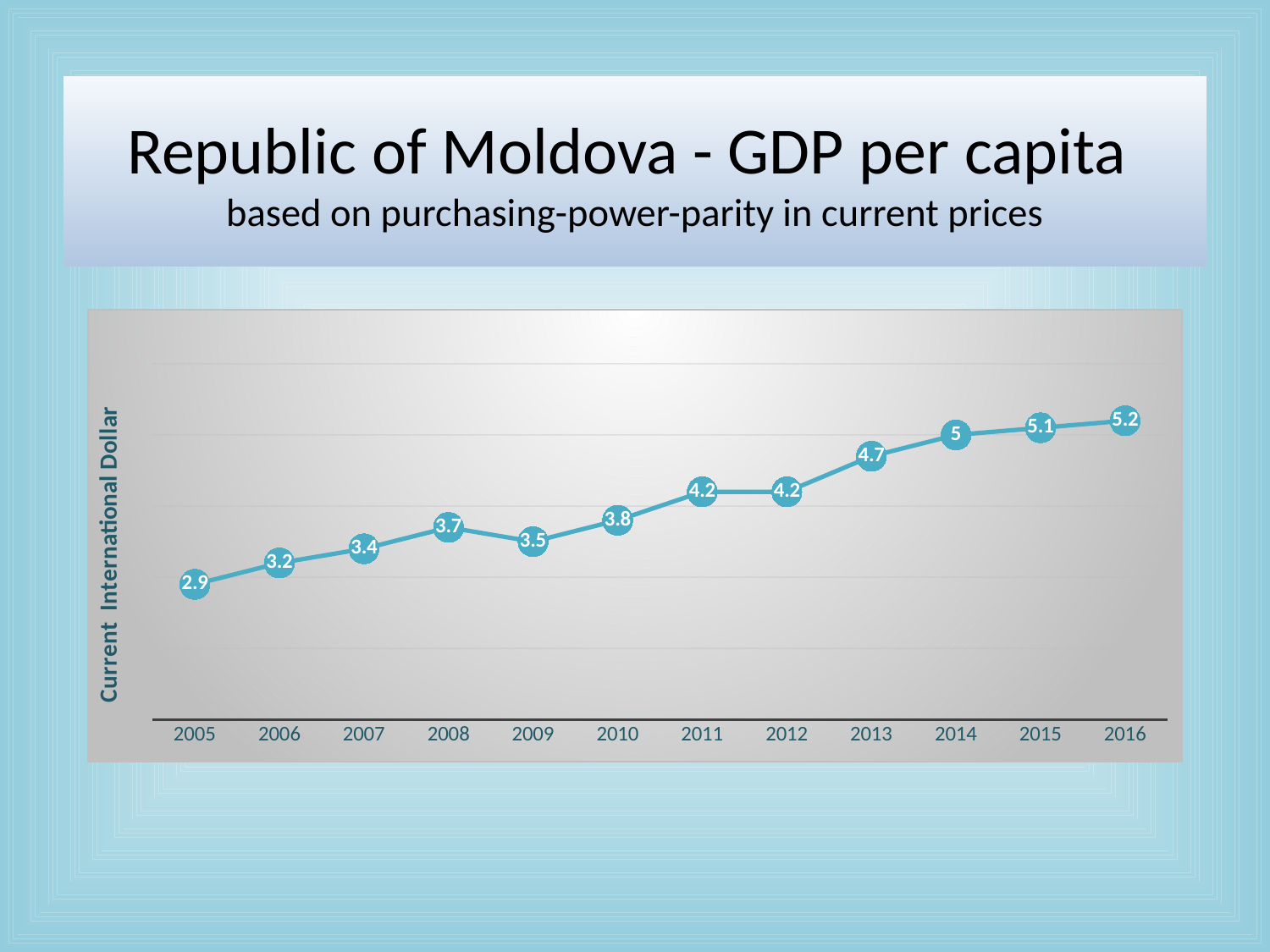
What is the label of the vertical axis? Current International Dollar What kind of chart is shown on the slide? line chart Which year has a larger value, 2008 or 2009? 2008 What is the difference between the values for 2016 and 2005? 2.3 What is the difference between the values for 2008 and 2009? 0.2 Do the values generally rise or fall from 2005 to 2016? rise How many years are plotted on the x axis? 12 What is the GDP per capita value shown for 2005? 2.9 What is the GDP per capita value shown for 2009? 3.5 Which year has the highest GDP per capita value? 2016 Which year has the lowest GDP per capita value? 2005 What is the GDP per capita value shown for 2013? 4.7